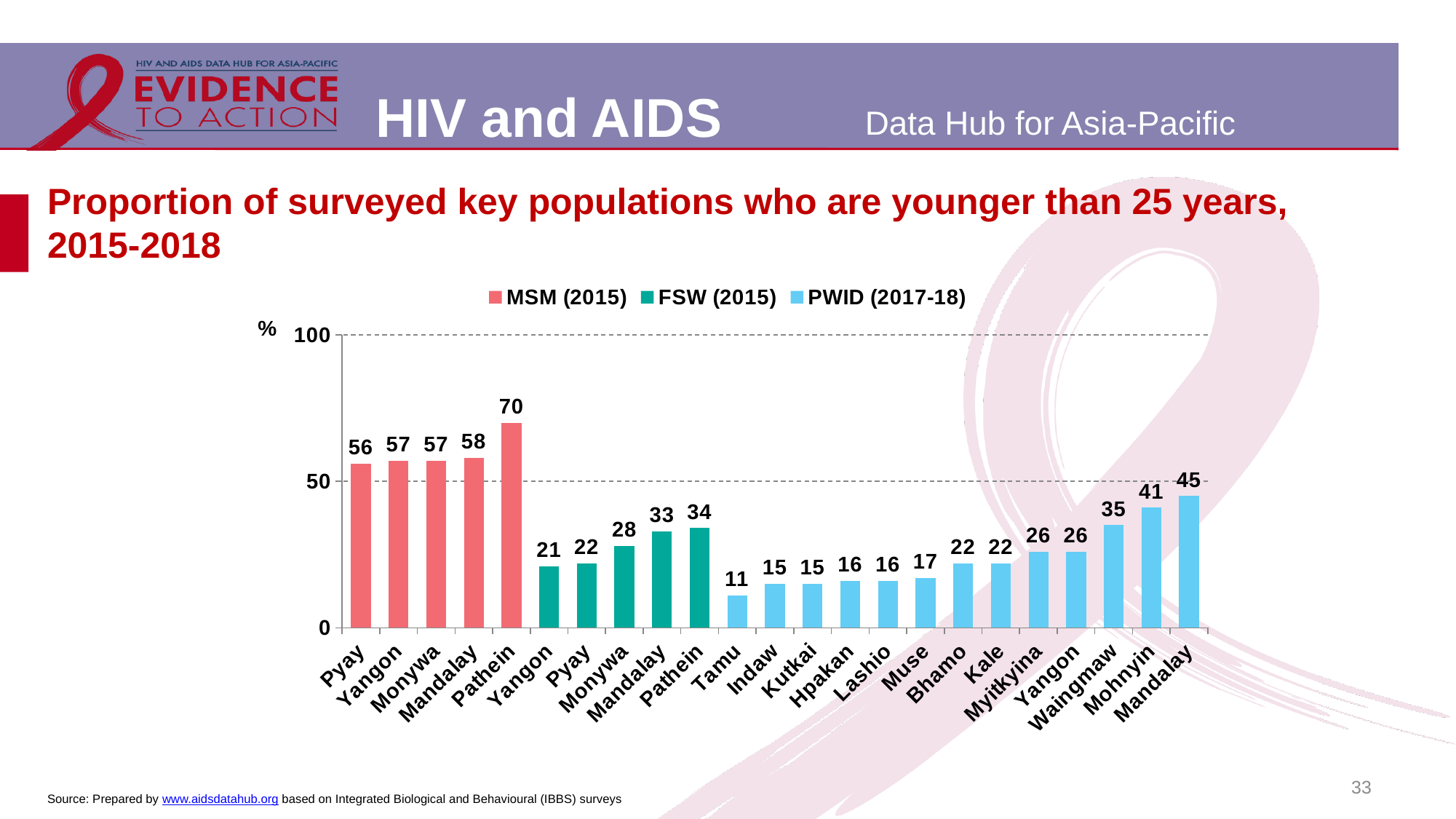
Which site has the highest value in the PWID (2017-18) series? Mandalay What is the value for Mandalay in the FSW (2015) series? 33 Which series is shown in light blue in the legend? PWID (2017-18) How many series does the legend list? 3 Which is larger: the PWID (2017-18) value for Mohnyin or the PWID (2017-18) value for Waingmaw? Mohnyin How many bars are plotted in the chart in total? 23 What is the difference between the MSM (2015) value for Pathein and the FSW (2015) value for Pathein? 36 Is the MSM (2015) value for Pyay greater or less than 50? greater Which site has the lowest value in the FSW (2015) series? Yangon What is the value for Pathein in the MSM (2015) series? 70 What is the value for Tamu in the PWID (2017-18) series? 11 What kind of chart is shown on the slide? bar chart